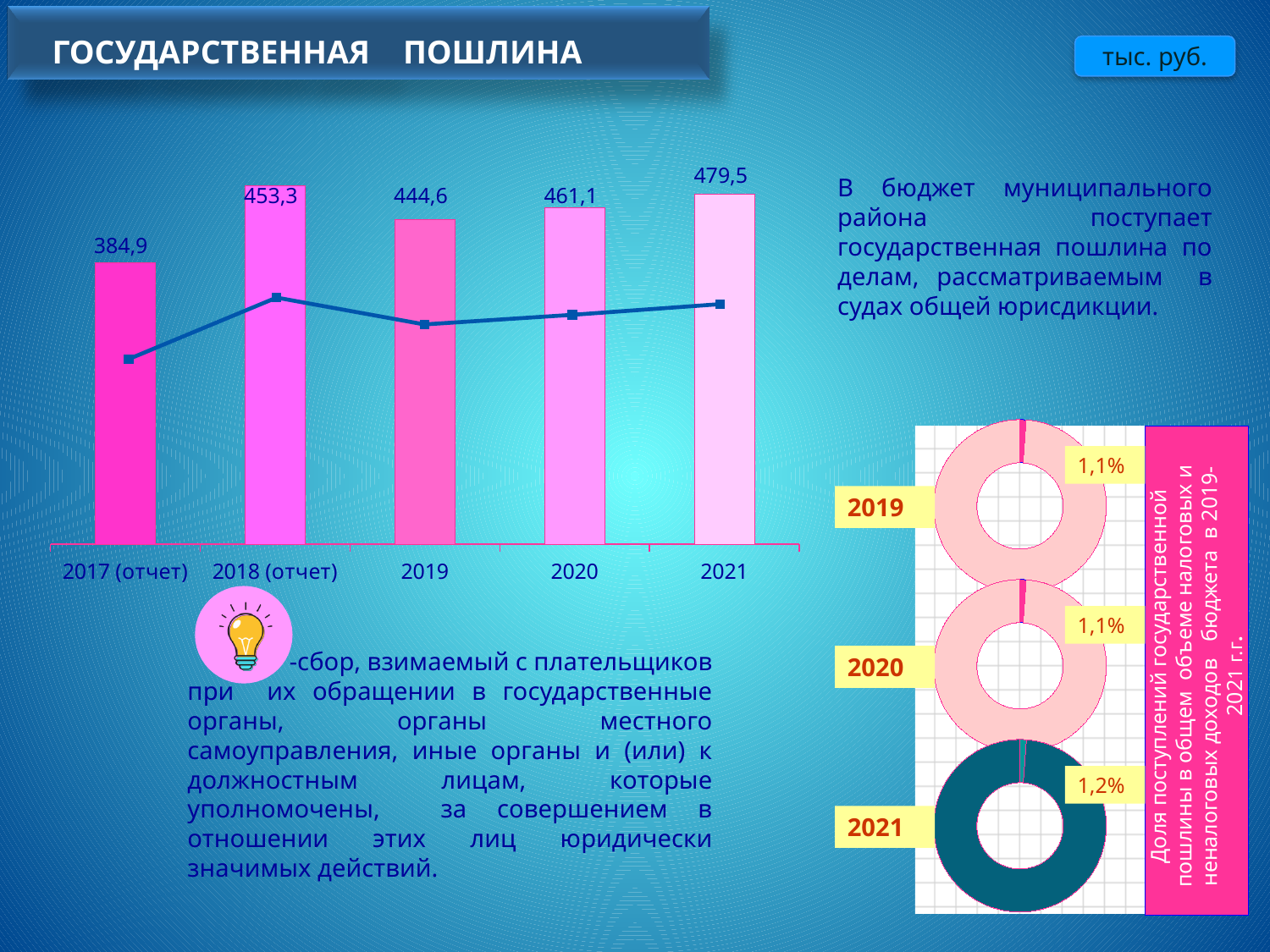
In the bar chart on the left, how many years are shown on the x axis? 5 In the bar chart on the left, which year has the lowest value? 2017 (отчет) In the bar chart on the left, what is the value for 2019? 444,6 In the bar chart on the left, what is the difference between the values for 2021 and 2017 (отчет)? 94,6 In the bar chart on the left, what is the value for 2021? 479,5 In the bar chart on the left, what is the difference between the values for 2020 and 2019? 16,5 In the bar chart on the left, what is the value for 2017 (отчет)? 384,9 In the donut charts on the right, what share is shown for 2021? 1,2% What unit of measurement is indicated in the top right corner of the slide? тыс. руб. In the bar chart on the left, which is larger: the value for 2018 (отчет) or the value for 2019? 2018 (отчет) In the donut charts on the right, what share is shown for 2019? 1,1%